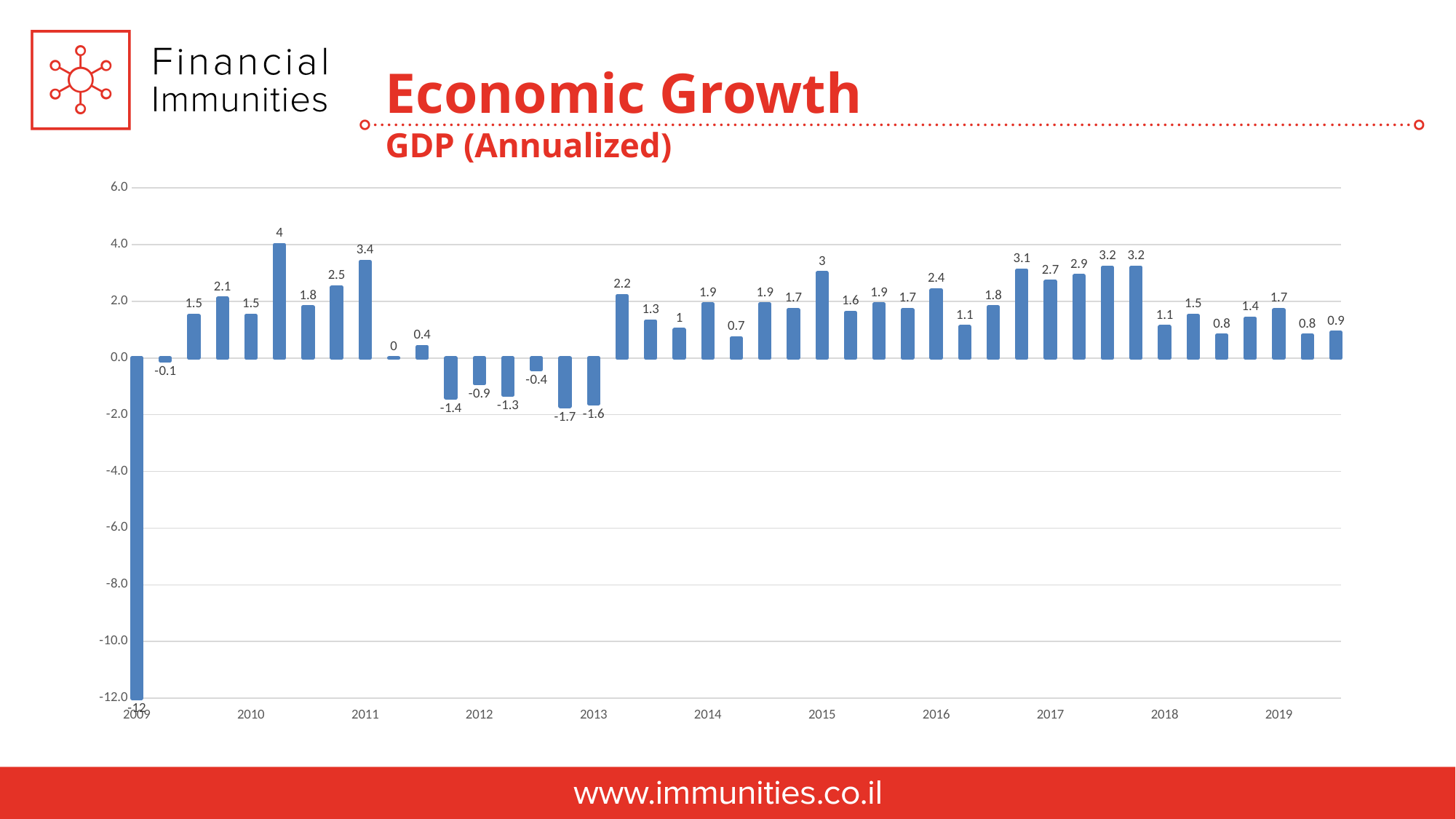
What is the title of the chart? GDP (Annualized) What is the lowest value shown on the vertical axis? -12.0 What is the highest value shown in the chart? 4 What is the difference between the highest bar (4) and the bar labeled 3.4? 0.6 How many bars are plotted in the chart? 43 What is the value of the bar directly above the 2015 axis label? 3 What is the value of the bar directly above the 2017 axis label? 2.7 What is the value of the bar directly above the 2009 axis label? -12 What type of chart is shown on the slide? bar chart What is the lowest value shown in the chart? -12 Which is larger: the bar directly above the 2016 axis label or the bar directly above the 2018 axis label? 2016 Is the value of the bar directly above the 2012 axis label greater or less than 0.0? less